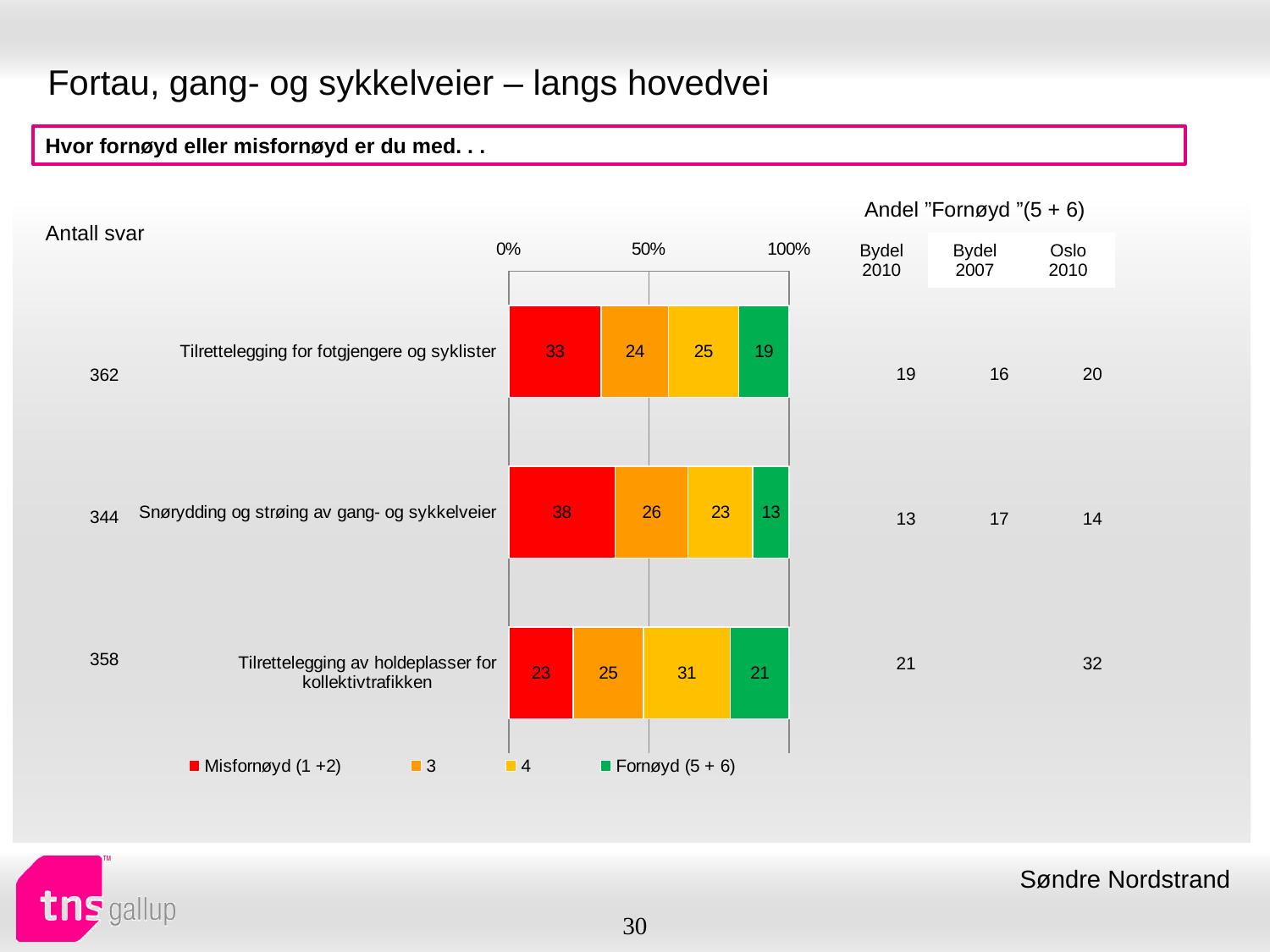
Which has the larger Fornøyd (5 + 6) value: "Tilrettelegging for fotgjengere og syklister" or "Tilrettelegging av holdeplasser for kollektivtrafikken"? Tilrettelegging av holdeplasser for kollektivtrafikken Which category has the highest Misfornøyd (1 +2) value? Snørydding og strøing av gang- og sykkelveier What is the value of the Misfornøyd (1 +2) segment for "Snørydding og strøing av gang- og sykkelveier"? 38 How much larger is the Misfornøyd (1 +2) value for "Snørydding og strøing av gang- og sykkelveier" than for "Tilrettelegging for fotgjengere og syklister"? 5 What is the value of the "4" segment for "Tilrettelegging for fotgjengere og syklister"? 25 What is the total of the stacked bar for "Snørydding og strøing av gang- og sykkelveier"? 100 How many series does the legend list? 4 What is the value of the Fornøyd (5 + 6) segment for "Tilrettelegging av holdeplasser for kollektivtrafikken"? 21 Which category has the lowest Fornøyd (5 + 6) value? Snørydding og strøing av gang- og sykkelveier What kind of chart is shown on the slide? Stacked bar chart How many categories are shown in the chart? 3 What is the difference between the "4" segment values for "Tilrettelegging av holdeplasser for kollektivtrafikken" and "Snørydding og strøing av gang- og sykkelveier"? 8